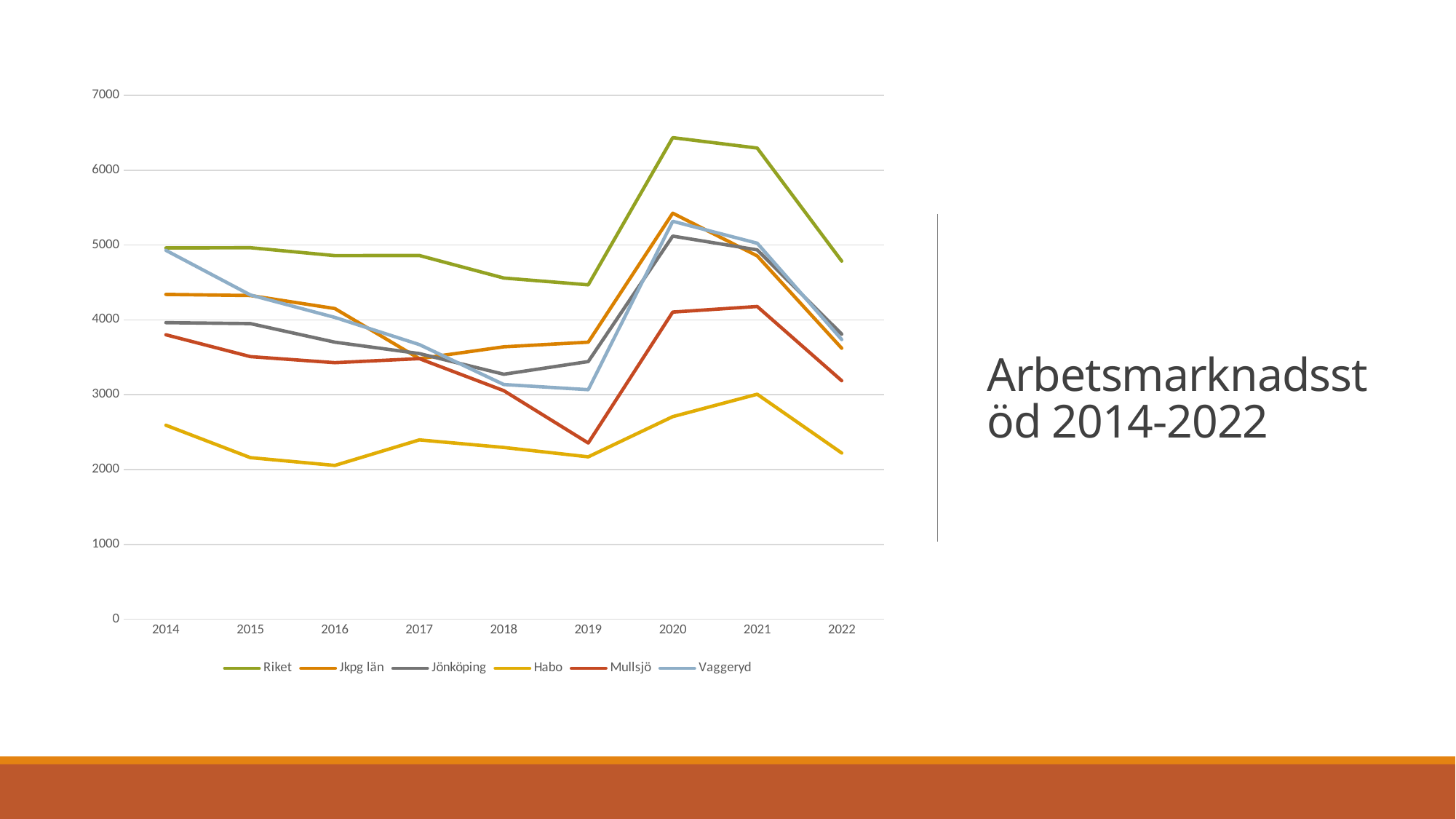
How many series does the legend list? 6 How many years are shown on the x axis? 9 Which series has the highest value in 2020? Riket Is the value for Jkpg län in 2020 greater or less than 5000? greater Is the value for Riket in 2020 greater or less than 6000? greater Which is larger in 2021, the value for Vaggeryd or the value for Mullsjö? Vaggeryd Does the Riket series rise or fall from 2020 to 2022? fall Which series has the lowest value in 2022? Habo What kind of chart is shown on the slide? line chart What is the title shown on the slide? Arbetsmarknadsstöd 2014-2022 In which year does the Riket series reach its highest value? 2020 Is the value for Habo in 2016 greater or less than 3000? less